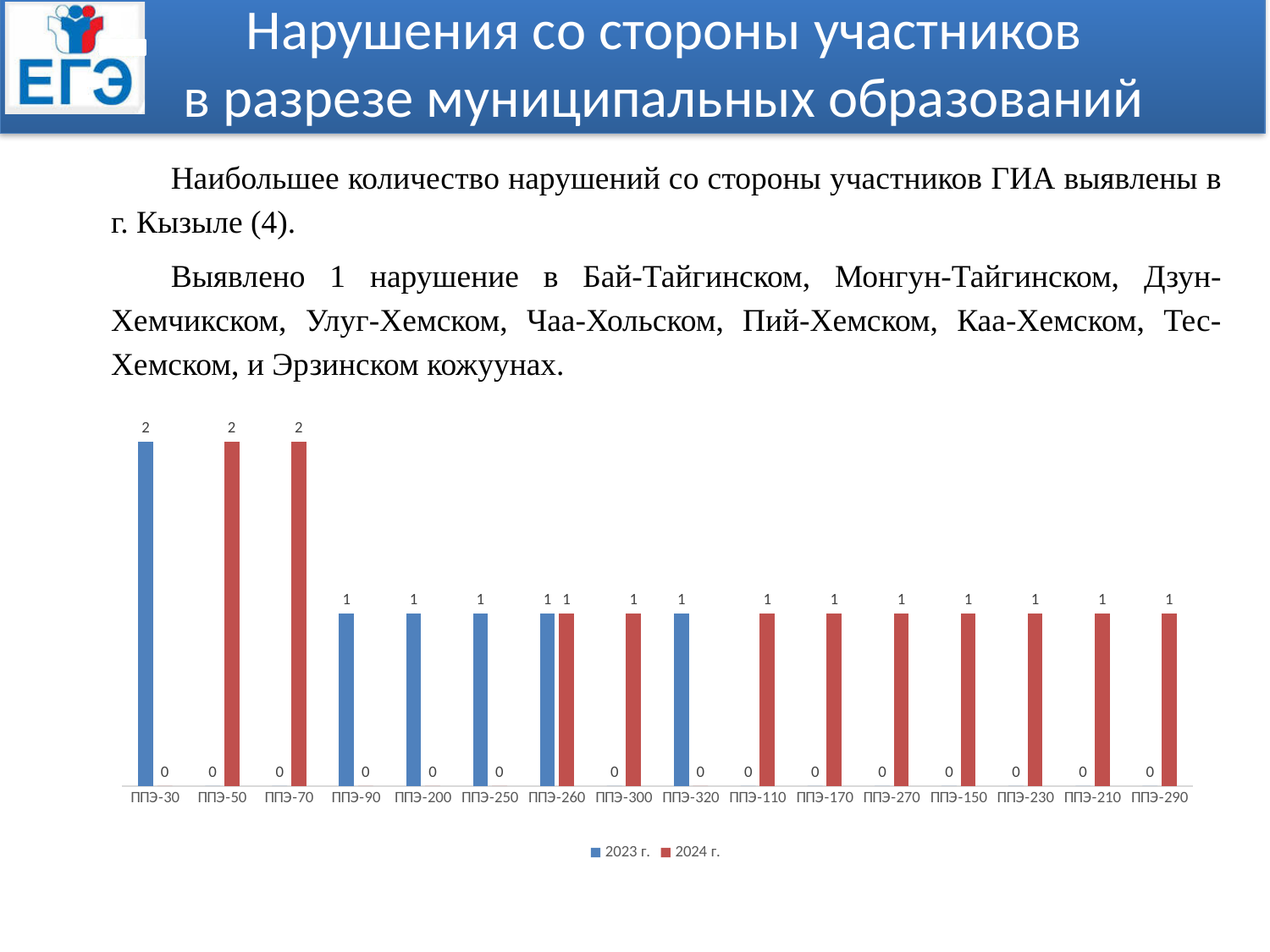
Which is larger for ППЭ-90: the 2023 г. value or the 2024 г. value? 2023 г. How many categories (ППЭ) are shown on the x axis of the chart? 16 What is the value for ППЭ-260 in the 2023 г. series? 1 What is the difference between the 2024 г. value for ППЭ-70 and the 2024 г. value for ППЭ-300? 1 How many series does the chart legend list? 2 What type of chart is shown on the slide? bar chart What is the value for ППЭ-290 in the 2023 г. series? 0 Which category has the highest value in the 2023 г. series? ППЭ-30 What is the value for ППЭ-50 in the 2024 г. series? 2 Which colour represents the 2024 г. series in the chart? red Which is larger for ППЭ-110: the 2023 г. value or the 2024 г. value? 2024 г. What is the value for ППЭ-30 in the 2023 г. series? 2